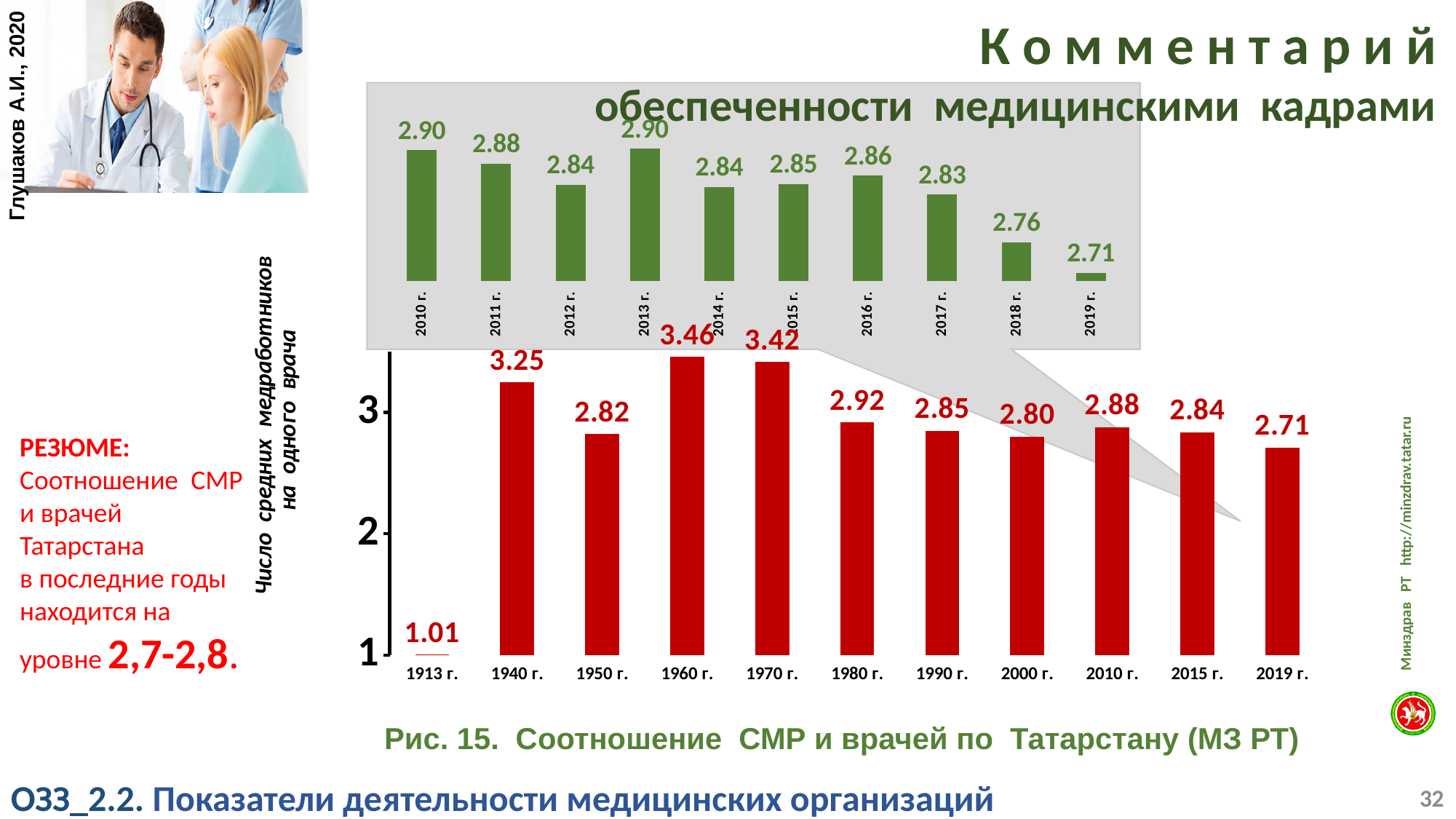
In the main red bar chart, what is the difference between the values for 1940 г. and 2019 г.? 0.54 In the inset green bar chart, how many years are shown? 10 In the main red bar chart, how many years are shown on the x axis? 11 What kind of chart is the main red chart? Bar chart In the main red bar chart, what is the value for 1960 г.? 3.46 In the main red bar chart, which year has the lowest value? 1913 г. In the inset green bar chart, which year has the lowest value? 2019 г. In the main red bar chart, what is the value for 1913 г.? 1.01 In the inset green bar chart, what is the difference between the values for 2010 г. and 2019 г.? 0.19 In the main red bar chart, which is larger: the value for 1980 г. or the value for 2000 г.? 1980 г. In the main red bar chart, which year has the highest value? 1960 г. In the inset green bar chart, what is the value for 2018 г.? 2.76